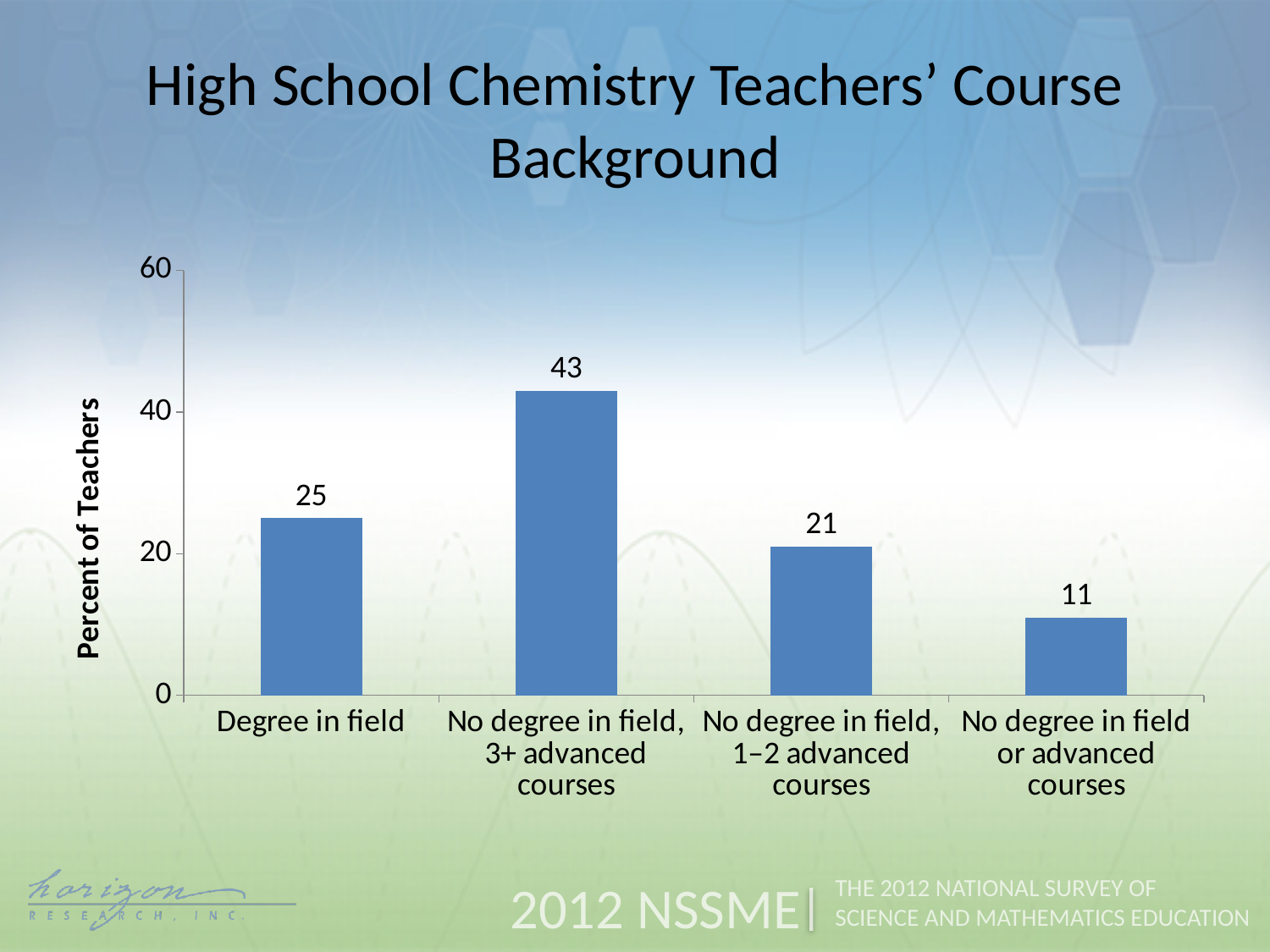
What is the value for 'No degree in field, 1–2 advanced courses'? 21 Is the value for 'No degree in field, 3+ advanced courses' greater or less than 40? greater What percent of teachers have a degree in field? 25 How many categories are shown on the x axis? 4 What is the value for 'No degree in field or advanced courses'? 11 Which is larger: 'Degree in field' or 'No degree in field, 1–2 advanced courses'? Degree in field What is the difference between 'No degree in field, 3+ advanced courses' and 'Degree in field'? 18 Which category has the highest percent of teachers? No degree in field, 3+ advanced courses Which category has the lowest percent of teachers? No degree in field or advanced courses What is the label of the y axis? Percent of Teachers What is the value for 'No degree in field, 3+ advanced courses'? 43 What kind of chart is shown on the slide? Bar chart